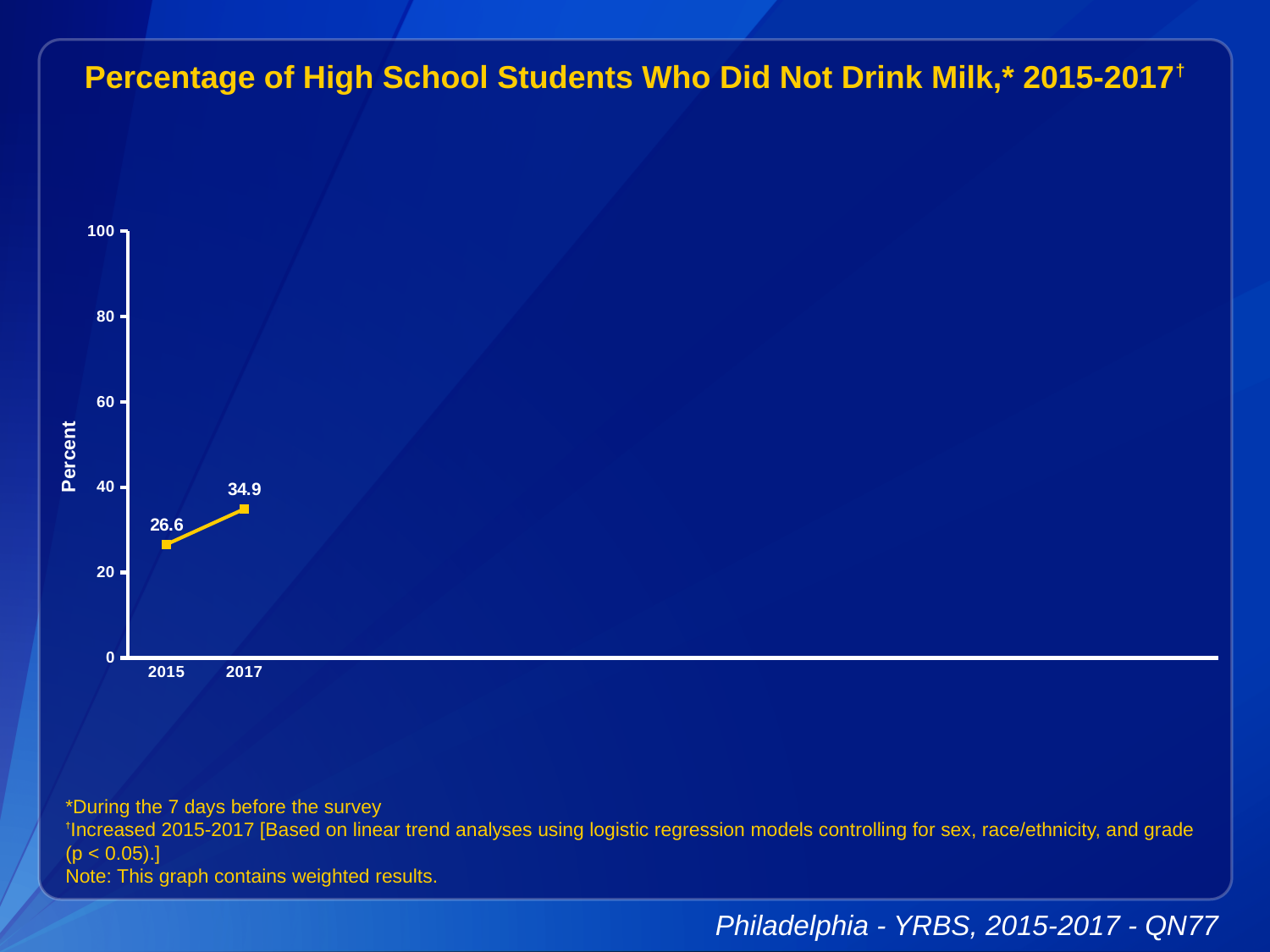
Which year has the highest value? 2017 What is the difference between the 2017 and 2015 values? 8.3 What kind of chart is shown on the slide? line chart Which is larger, the value for 2015 or the value for 2017? 2017 Do the values rise or fall from 2015 to 2017? rise How many data points are plotted on the chart? 2 Is the value for 2017 greater or less than 40? less Which year has the lowest value? 2015 Is the value for 2015 greater or less than 20? greater What is the label on the y axis? Percent What is the value for 2015? 26.6 What is the value for 2017? 34.9